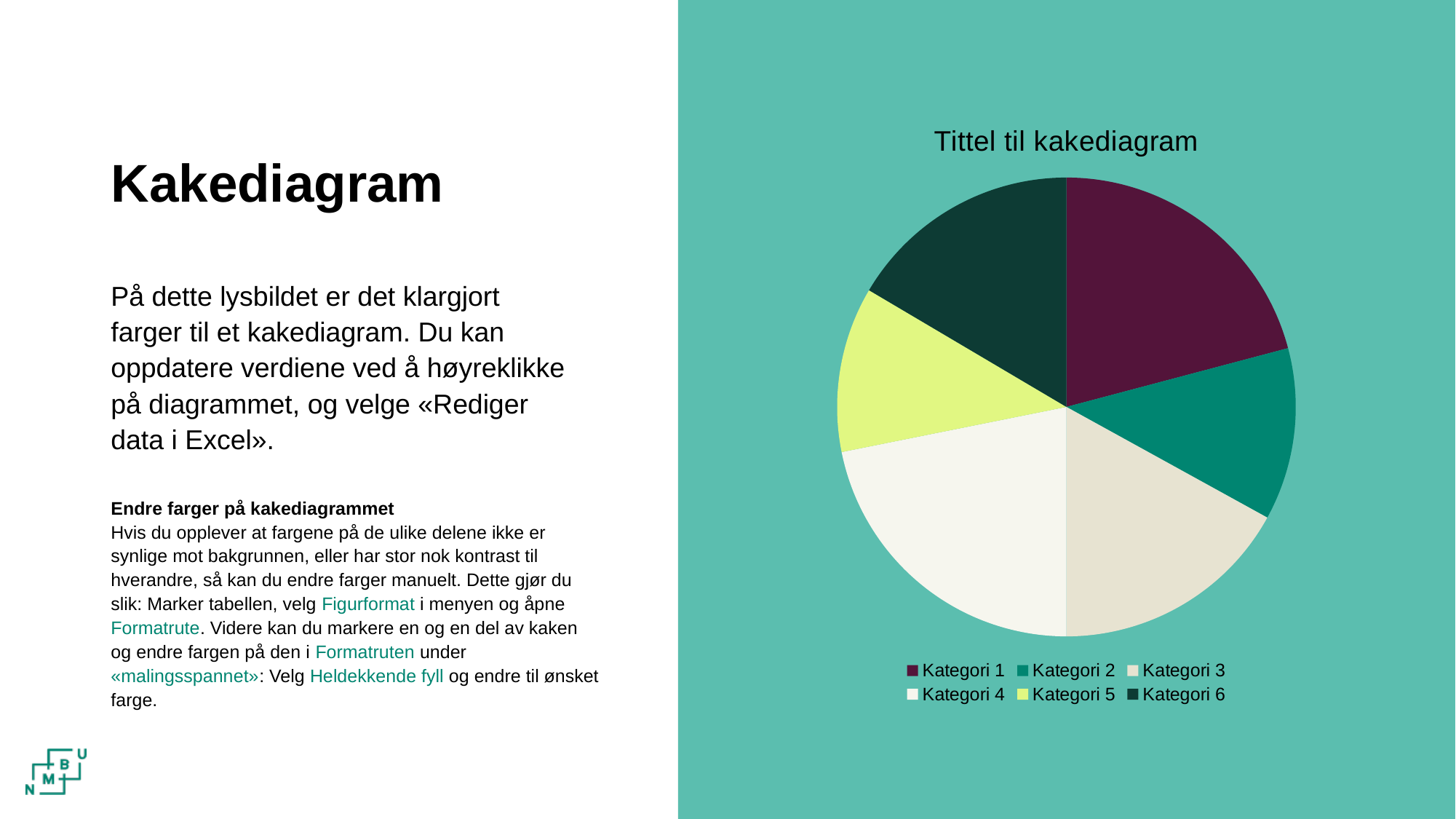
How many slices does the pie chart have? 6 What is the label of the first entry in the pie chart's legend? Kategori 1 Which slice is larger, Kategori 6 or Kategori 5? Kategori 6 Which slice is larger, Kategori 3 or Kategori 2? Kategori 3 Which slice is larger, Kategori 1 or Kategori 2? Kategori 1 What kind of chart is shown on the slide? pie chart How many entries does the legend of the pie chart list? 6 What is the title of the pie chart? Tittel til kakediagram